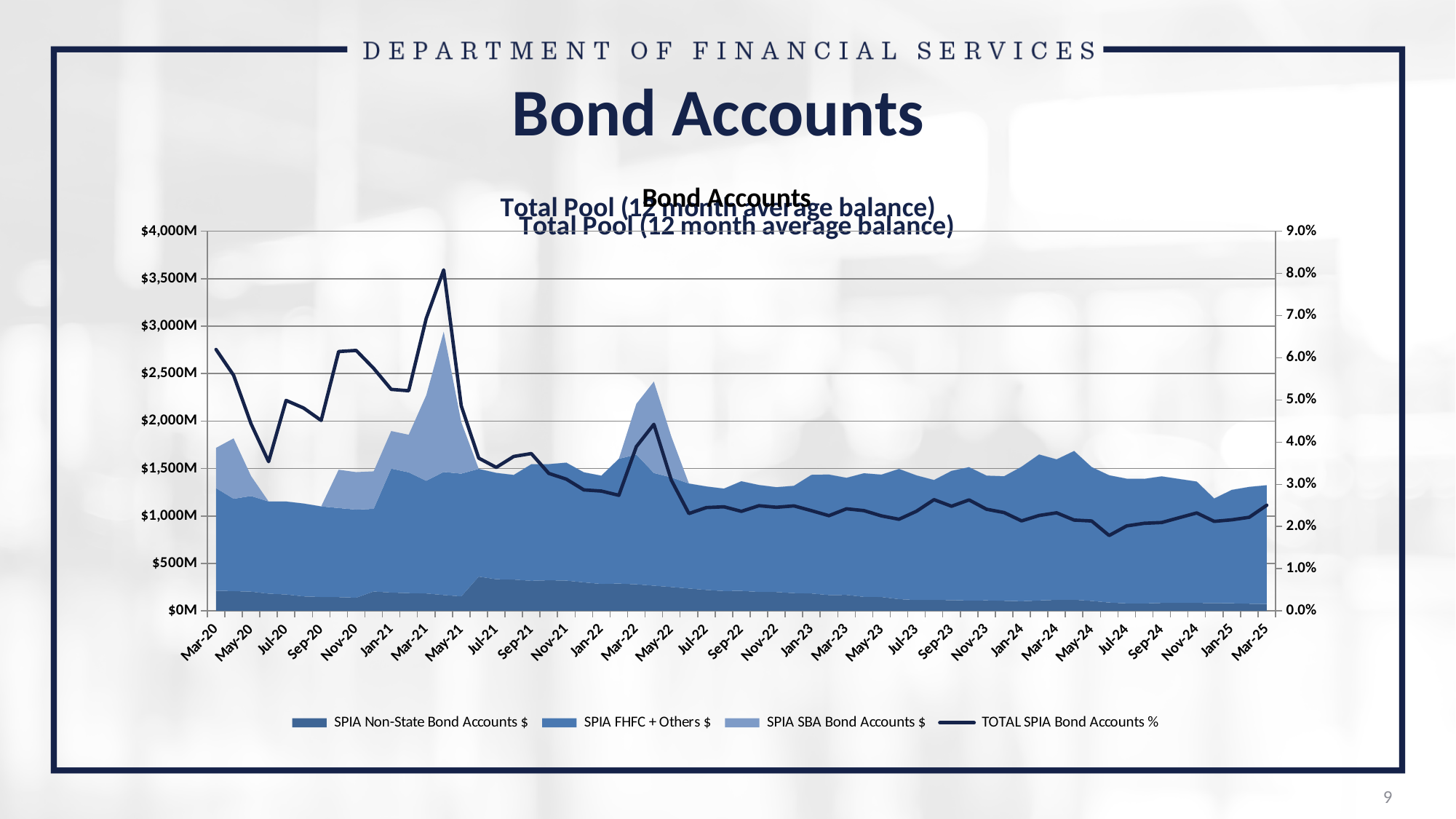
Does the TOTAL SPIA Bond Accounts % line generally rise or fall from Mar-20 to Mar-25? fall How many month labels are shown along the x axis? 31 Is the total stacked balance at Mar-21 greater or less than $2,500M? less What kind of chart is shown on the slide? Stacked area chart with a line At which month does the TOTAL SPIA Bond Accounts % line reach its lowest point? Jun-24 Which series is plotted as a line rather than an area? TOTAL SPIA Bond Accounts % Is the total stacked balance at Mar-25 greater or less than $1,000M? greater What is the highest value shown on the left vertical axis? $4,000M How many series does the legend list? 4 At which month does the TOTAL SPIA Bond Accounts % line reach its highest point? Apr-21